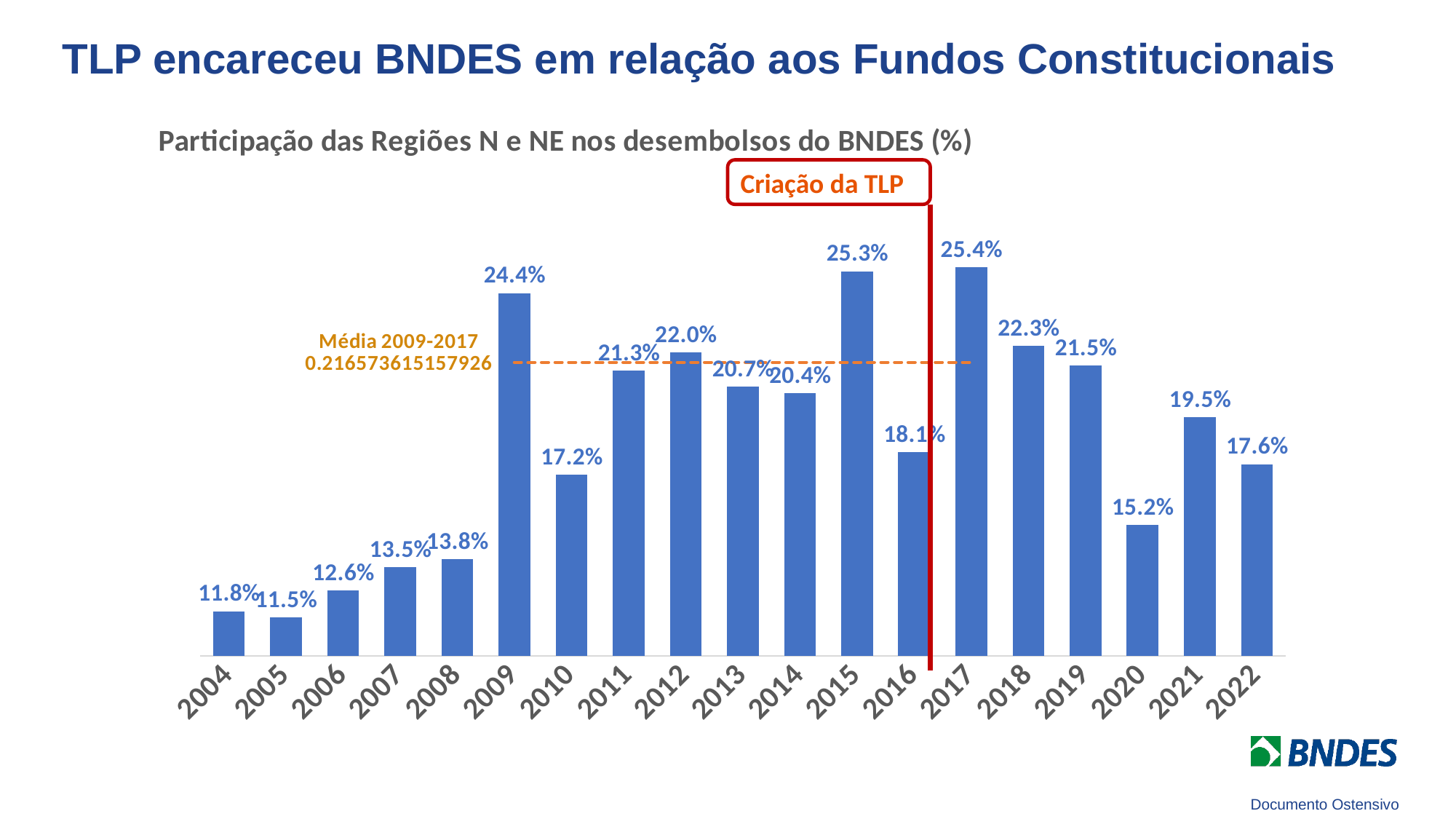
Do the values rise or fall from 2004 to 2009? Rise How many years are shown on the x axis? 19 What is the value for 2022? 17.6% What kind of chart is this? Bar chart What is the difference between the values for 2009 and 2008? 10.6 percentage points What is the difference between the values for 2017 and 2016? 7.3 percentage points What is the value for 2016? 18.1% What event does the red vertical line mark, according to the annotation? Criação da TLP What is the value for 2009? 24.4% Which is larger, the value for 2018 or the value for 2019? 2018 What is the value for 2020? 15.2% Which year has the highest value? 2017